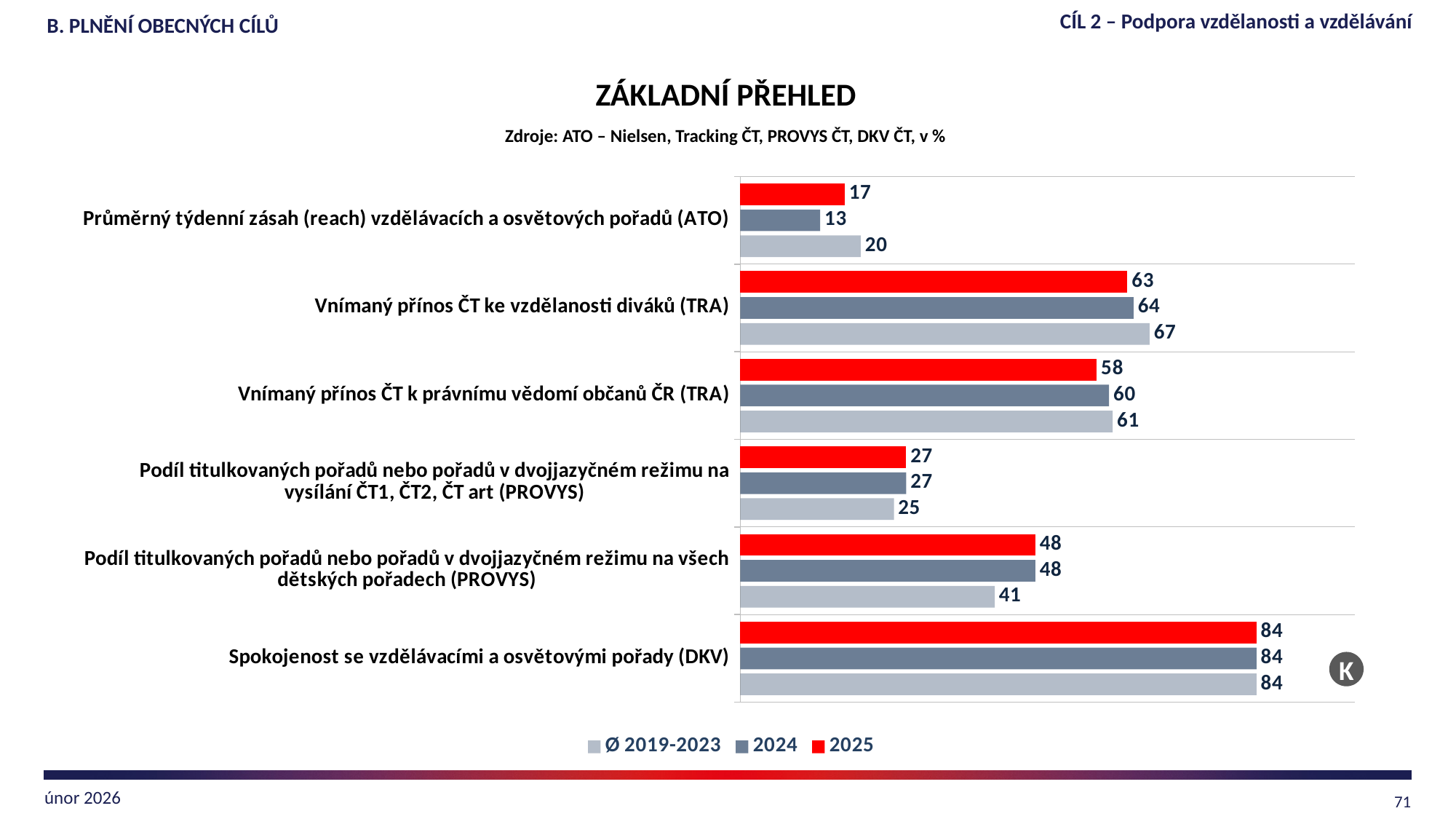
Which colour represents the 2025 series in the chart? Red What is the Ø 2019-2023 value for Vnímaný přínos ČT ke vzdělanosti diváků (TRA)? 67 Which category has the lowest 2024 value? Průměrný týdenní zásah (reach) vzdělávacích a osvětových pořadů (ATO) How many categories are shown on the chart? 6 What is the difference between the 2024 and Ø 2019-2023 values for Podíl titulkovaných pořadů nebo pořadů v dvojjazyčném režimu na všech dětských pořadech (PROVYS)? 7 What is the difference between the 2025 and 2024 values for Průměrný týdenní zásah (reach) vzdělávacích a osvětových pořadů (ATO)? 4 How many series does the legend list? 3 For Vnímaný přínos ČT k právnímu vědomí občanů ČR (TRA), which is larger: the 2025 value or the Ø 2019-2023 value? Ø 2019-2023 What is the 2024 value for Podíl titulkovaných pořadů nebo pořadů v dvojjazyčném režimu na všech dětských pořadech (PROVYS)? 48 Which category has the highest 2025 value? Spokojenost se vzdělávacími a osvětovými pořady (DKV) What kind of chart is shown on the slide? Bar chart What is the 2025 value for Průměrný týdenní zásah (reach) vzdělávacích a osvětových pořadů (ATO)? 17